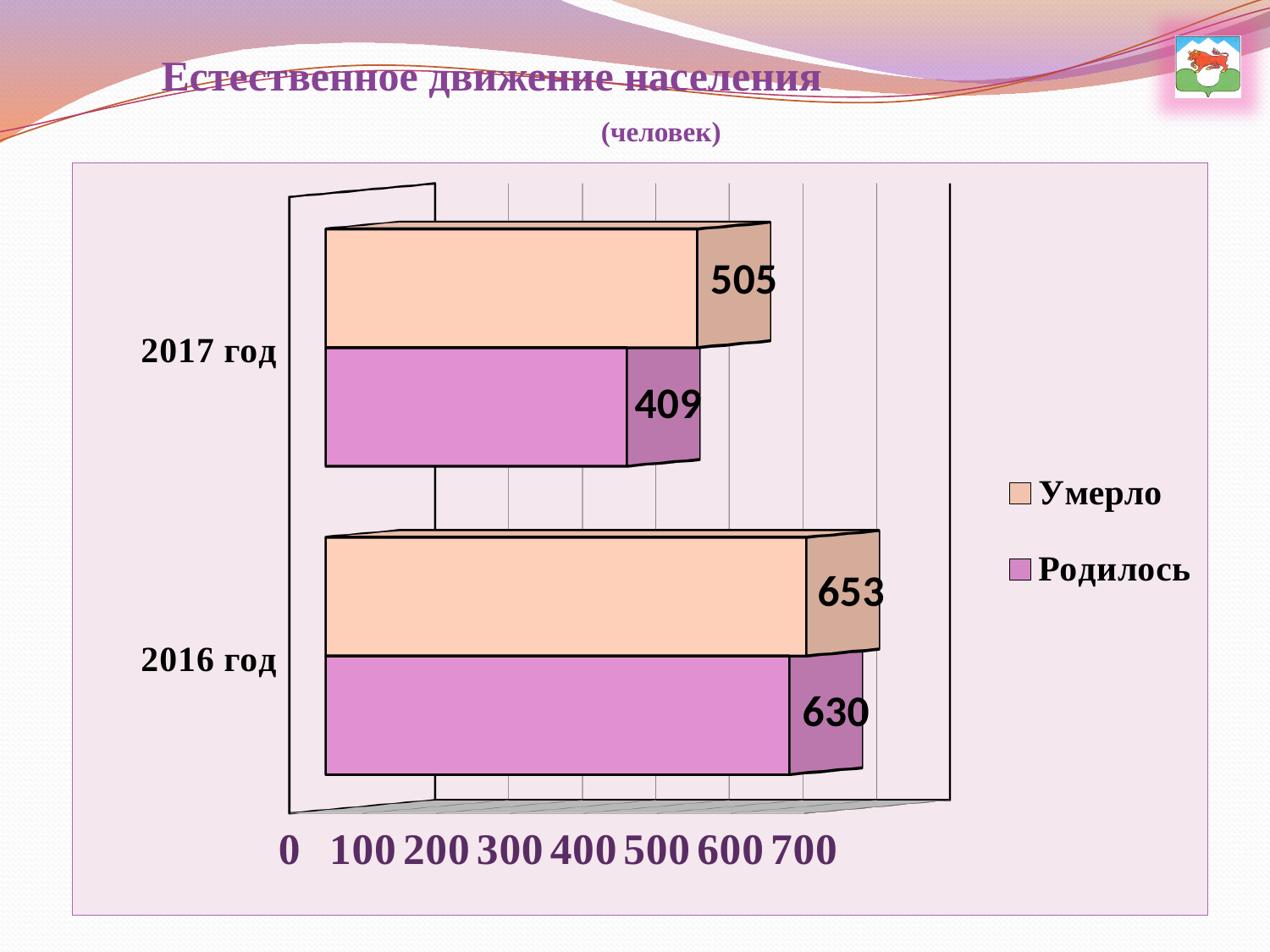
What is the difference between Родилось in 2016 год and Родилось in 2017 год? 221 Which is larger in 2016 год, Умерло or Родилось? Умерло What is the value for Родилось in 2017 год? 409 What kind of chart is shown on the slide? Bar chart How many series does the legend list? 2 What is the title of the chart? Естественное движение населения Which year has the lower value for Умерло? 2017 год Which year has the higher value for Родилось? 2016 год What is the value for Умерло in 2017 год? 505 What is the value for Умерло in 2016 год? 653 What is the difference between Умерло and Родилось in 2017 год? 96 What is the value for Родилось in 2016 год? 630